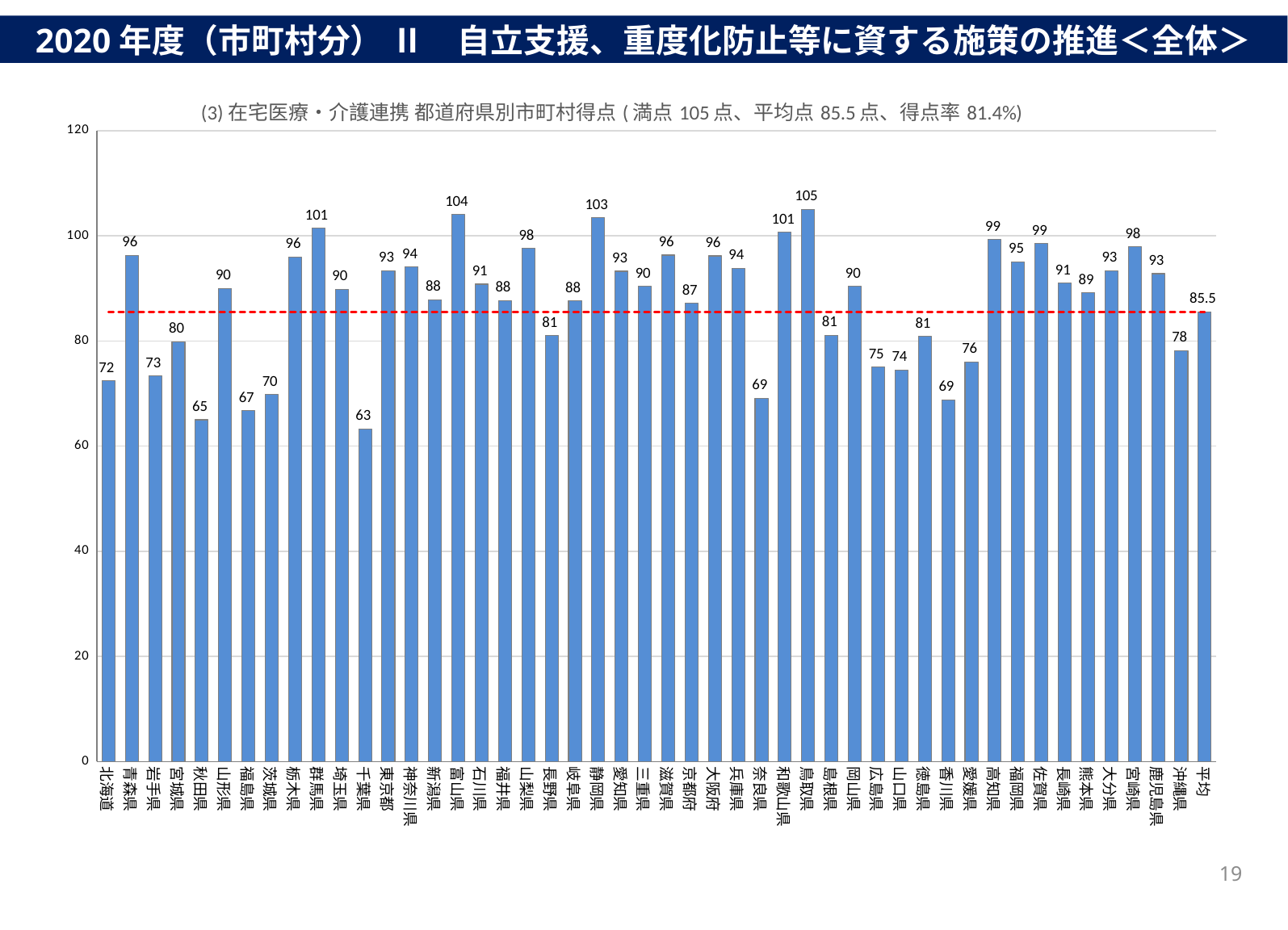
Which prefecture has the highest value? 鳥取県 Which has the larger value, 群馬県 or 静岡県? 静岡県 What is the difference between the values for 富山県 and 北海道? 32 What is the value for 和歌山県? 101 What average score (平均点) is stated in the chart title? 85.5点 What is the value shown for 平均? 85.5 What is the value for 鳥取県? 105 How many bars are plotted in the chart, including 平均? 48 Is the value for 奈良県 greater or less than 80? less Which prefecture has the lowest value? 千葉県 What is the value for 千葉県? 63 What kind of chart is shown on the slide? bar chart